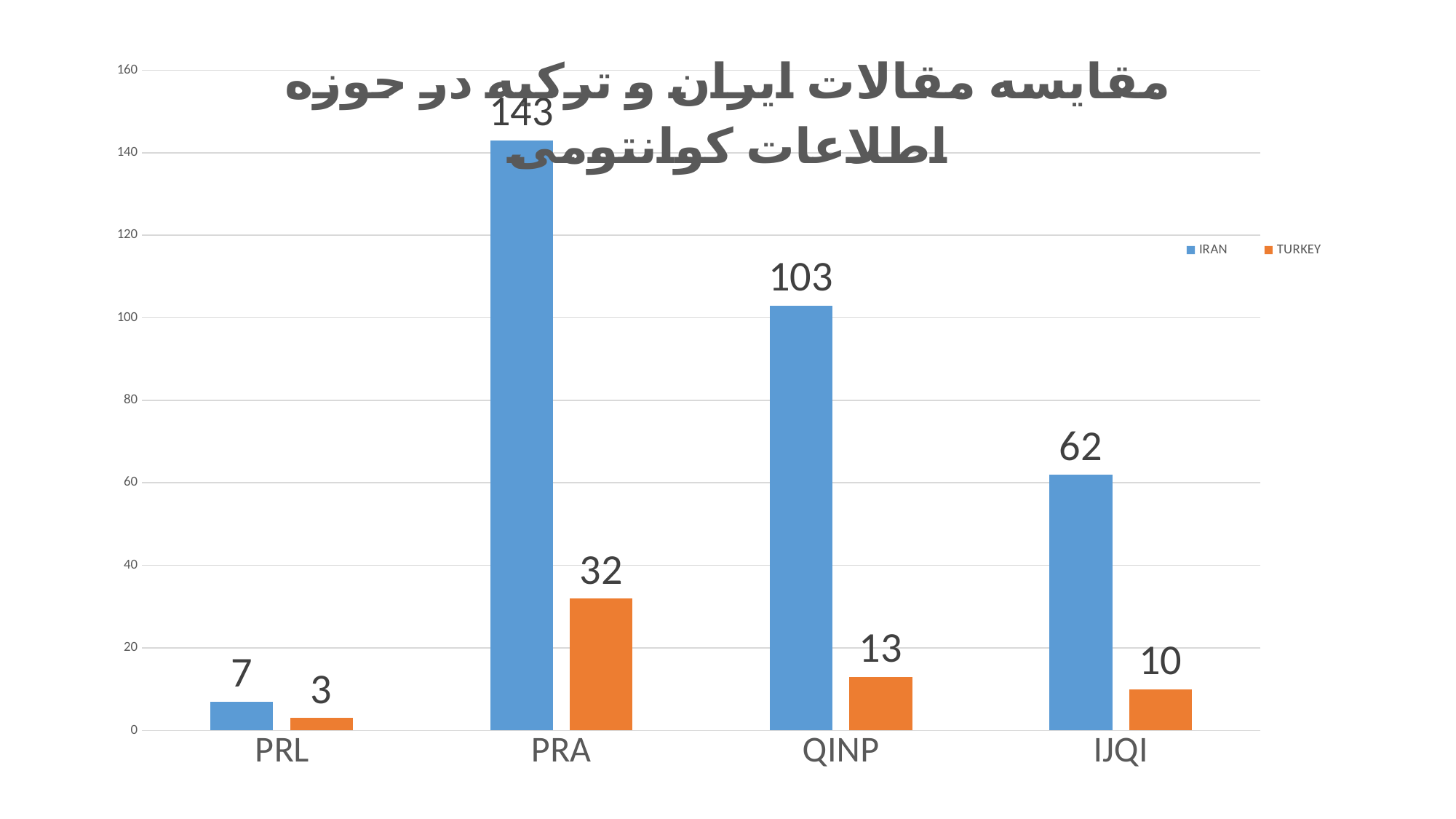
What is the value for TURKEY in the QINP category? 13 What colour are the bars for the TURKEY series? Orange What kind of chart is shown on the slide? Bar chart Which category has the highest value for IRAN? PRA What is the value for TURKEY in the PRL category? 3 How many series does the legend list? 2 How many categories are shown on the x axis? 4 Which is larger, the IRAN value for IJQI or the TURKEY value for PRA? IRAN value for IJQI What is the value for IRAN in the PRA category? 143 What is the difference between the IRAN and TURKEY values in the QINP category? 90 Which category has the lowest value for TURKEY? PRL What is the value for IRAN in the IJQI category? 62